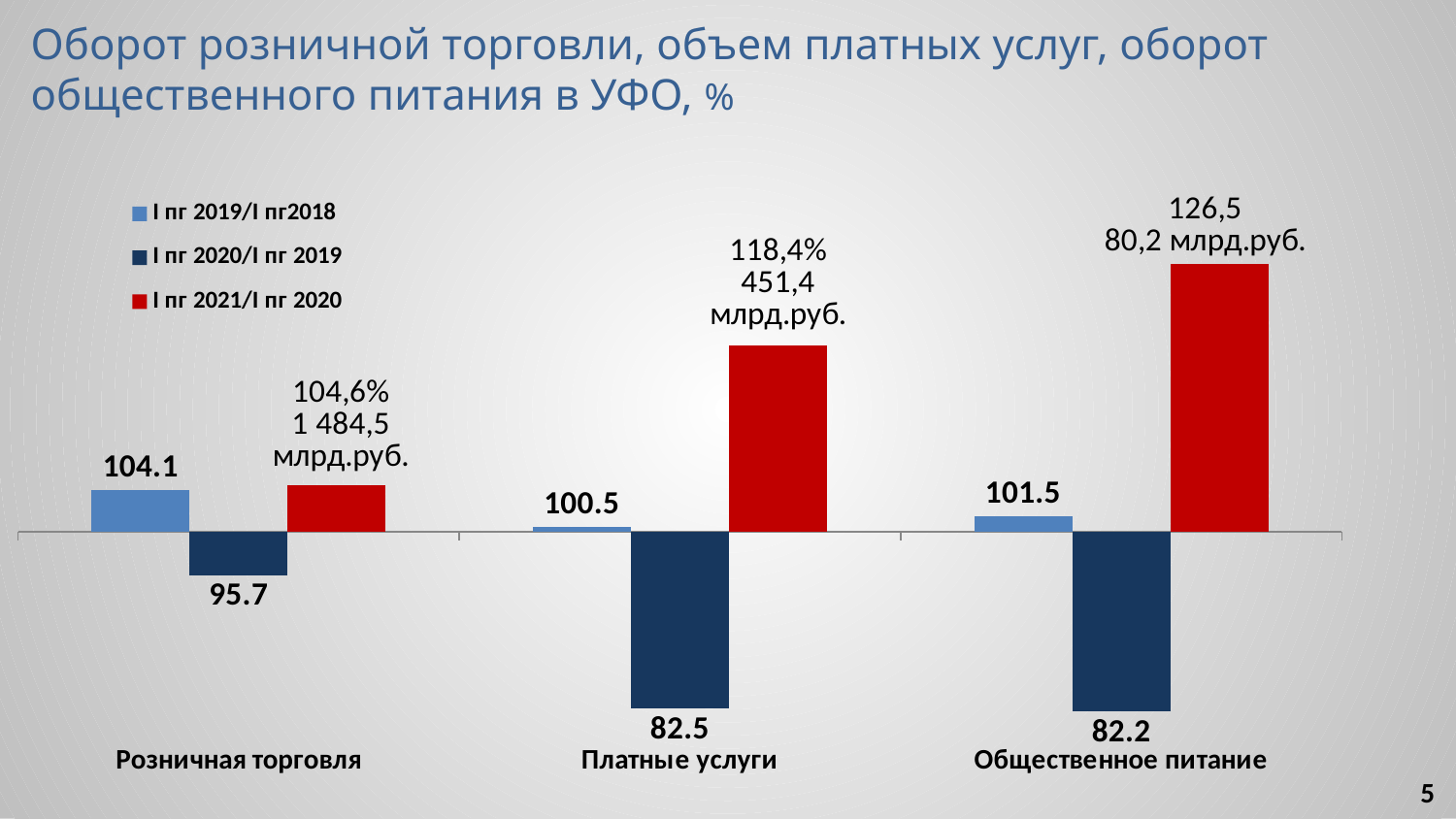
Which category has the highest value in the I пг 2021/I пг 2020 series? Общественное питание What is the value for Платные услуги in the I пг 2020/I пг 2019 series? 82.5 What is the value for Розничная торговля in the I пг 2019/I пг 2018 series? 104.1 What is the value for Платные услуги in the I пг 2021/I пг 2020 series? 118,4% How many series does the legend list? 3 What is the value for Общественное питание in the I пг 2020/I пг 2019 series? 82.2 Which is larger for Платные услуги: the I пг 2019/I пг 2018 value or the I пг 2021/I пг 2020 value? I пг 2021/I пг 2020 What is the difference between the I пг 2019/I пг 2018 value and the I пг 2020/I пг 2019 value for Розничная торговля? 8.4 What is the value for Общественное питание in the I пг 2021/I пг 2020 series? 126,5 How many categories are shown on the x axis? 3 Which category has the lowest value in the I пг 2019/I пг 2018 series? Платные услуги What kind of chart is shown on the slide? Bar chart